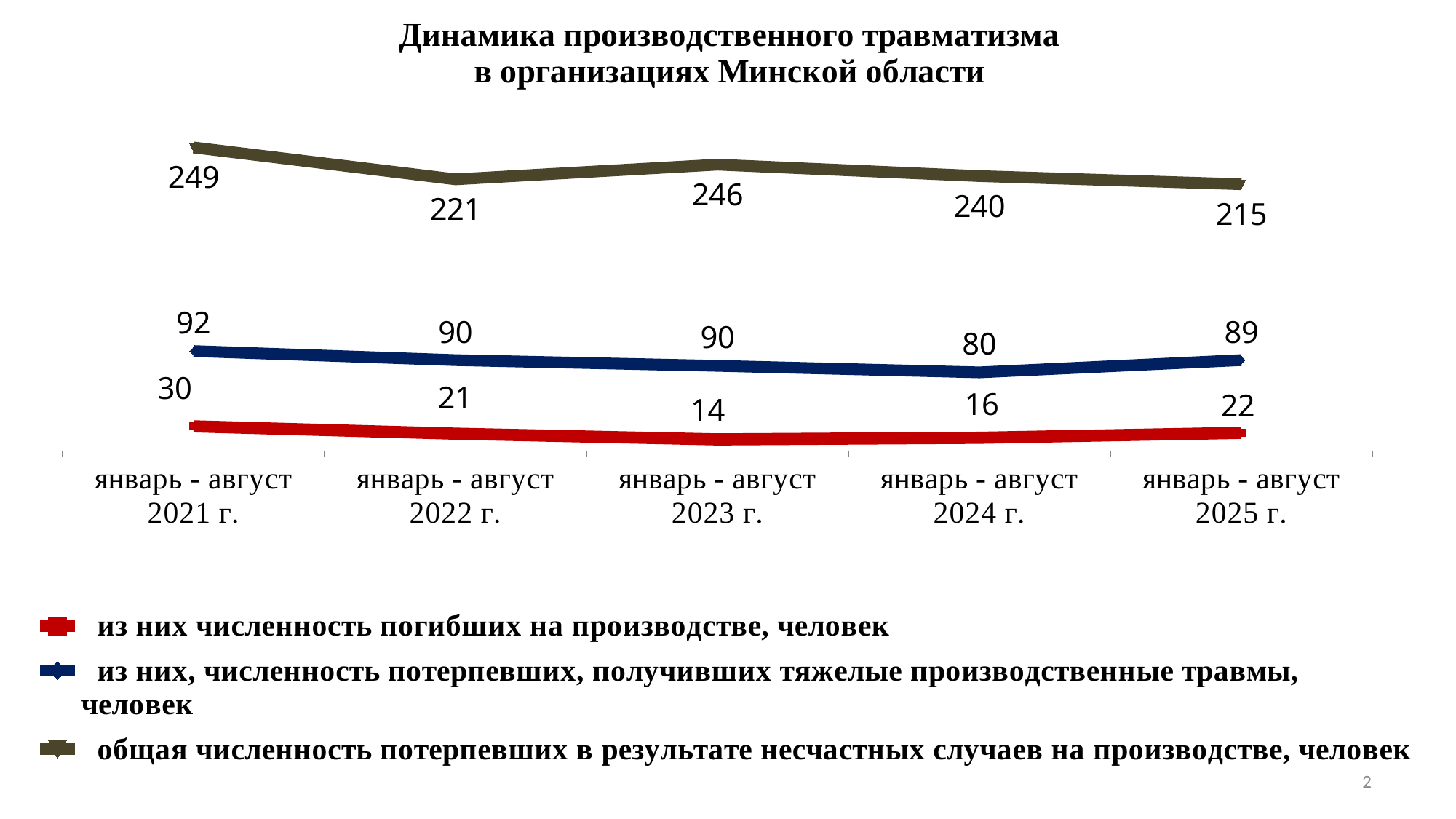
What is the number of people who received severe industrial injuries (тяжелые производственные травмы) for январь - август 2024 г.? 80 Which is larger: the number of severely injured in январь - август 2022 г. or in январь - август 2024 г.? январь - август 2022 г. In which period is the total number of victims of industrial accidents the lowest? январь - август 2025 г. What colour is the line for the number of people killed at work? red What is the total number of victims of industrial accidents (общая численность потерпевших) for январь - август 2021 г.? 249 In which period is the number of people killed at work the highest? январь - август 2021 г. What is the number of people killed at work (численность погибших на производстве) for январь - август 2023 г.? 14 What is the difference between the total number of victims in январь - август 2021 г. and январь - август 2025 г.? 34 What is the difference between the number of people killed at work in январь - август 2021 г. and январь - август 2023 г.? 16 What kind of chart is shown on the slide? line chart How many periods are shown on the x axis? 5 How many series does the legend list? 3